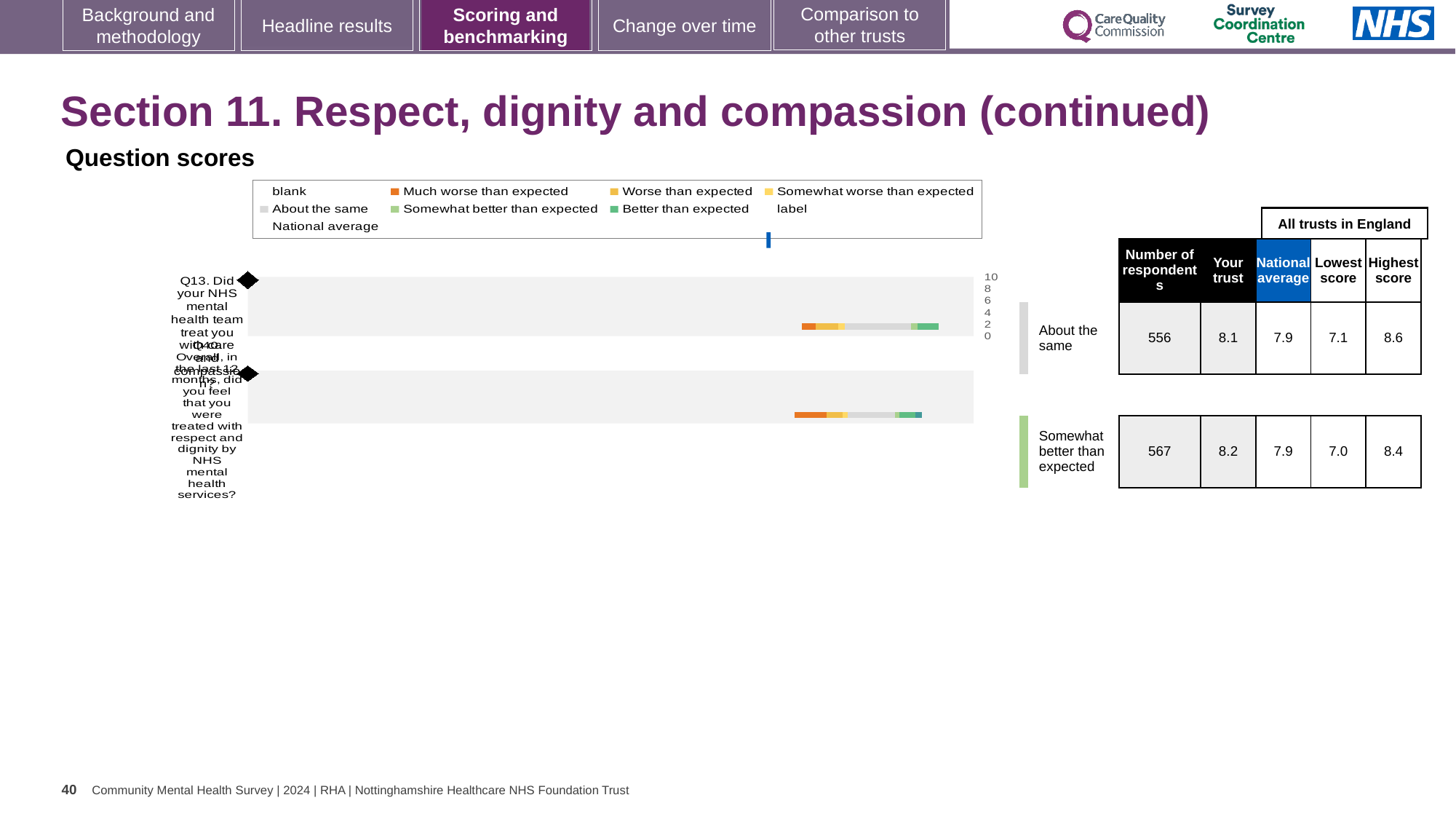
What benchmark category is Q13 placed in? About the same What is the 'Your trust' score for Q13? 8.1 What is the national average score for Q13? 7.9 Which question has the higher 'Your trust' score, Q13 or Q14? Q14 What is the 'Your trust' score for Q14? 8.2 What is the difference between the trust's score and the national average for Q14? 0.3 How many questions (categories) are plotted in the chart? 2 What kind of chart is shown on the slide? bar chart What is the lowest score among all trusts in England for Q14? 7.0 What is the highest score among all trusts in England for Q13? 8.6 What is the number of respondents for Q14? 567 What benchmark category is Q14 placed in? Somewhat better than expected